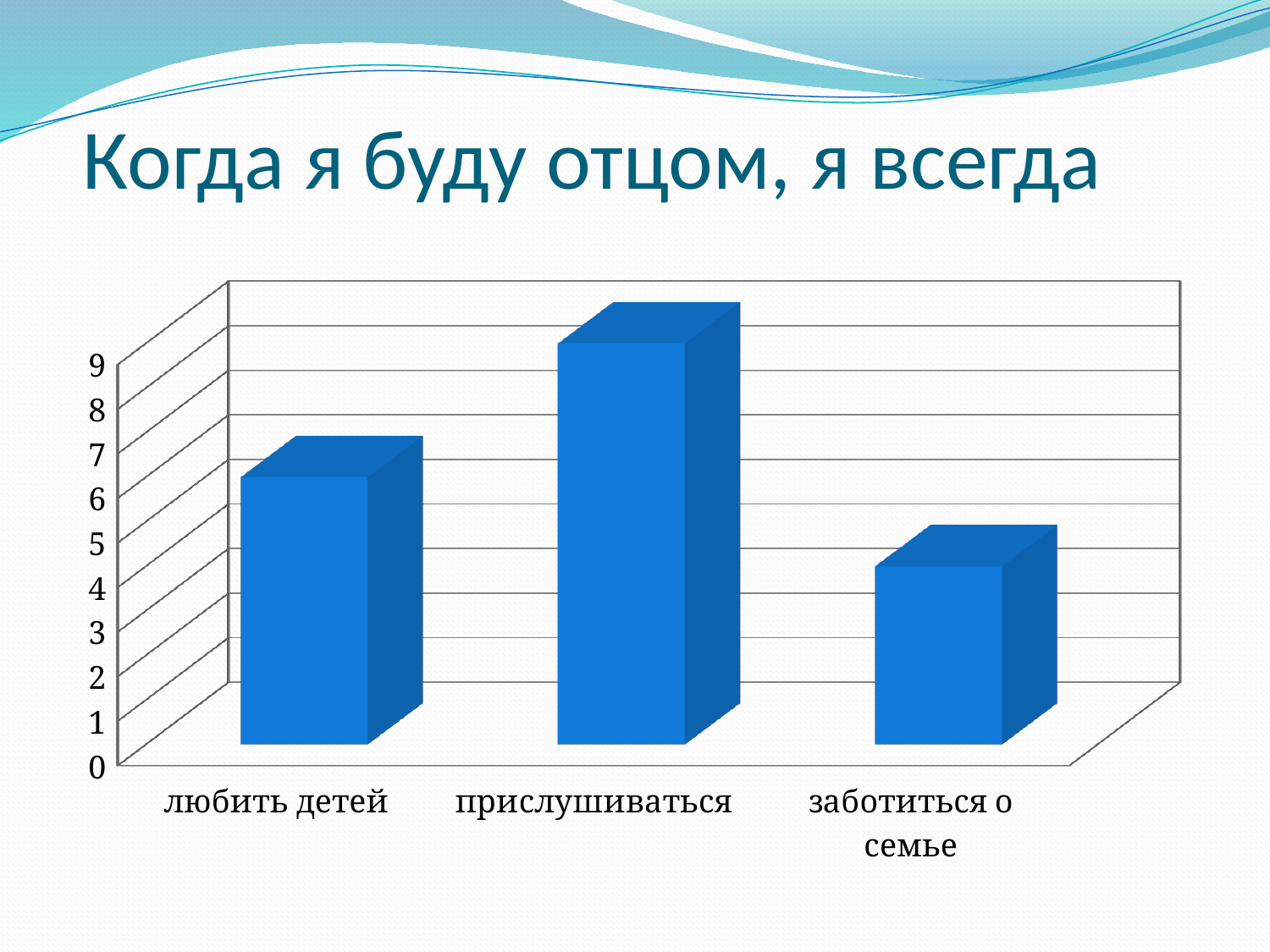
What kind of chart is shown on the slide? bar chart Is the value for любить детей greater or less than 4? greater Is the value for прислушиваться greater or less than 7? greater What is the title of the slide above the chart? Когда я буду отцом, я всегда Which category has the highest bar? прислушиваться Is the value for заботиться о семье greater or less than 2? greater Which is larger, the value for прислушиваться or the value for любить детей? прислушиваться Which is larger, the value for любить детей or the value for заботиться о семье? любить детей Which category has the lowest bar? заботиться о семье How many categories are shown on the x axis of the chart? 3